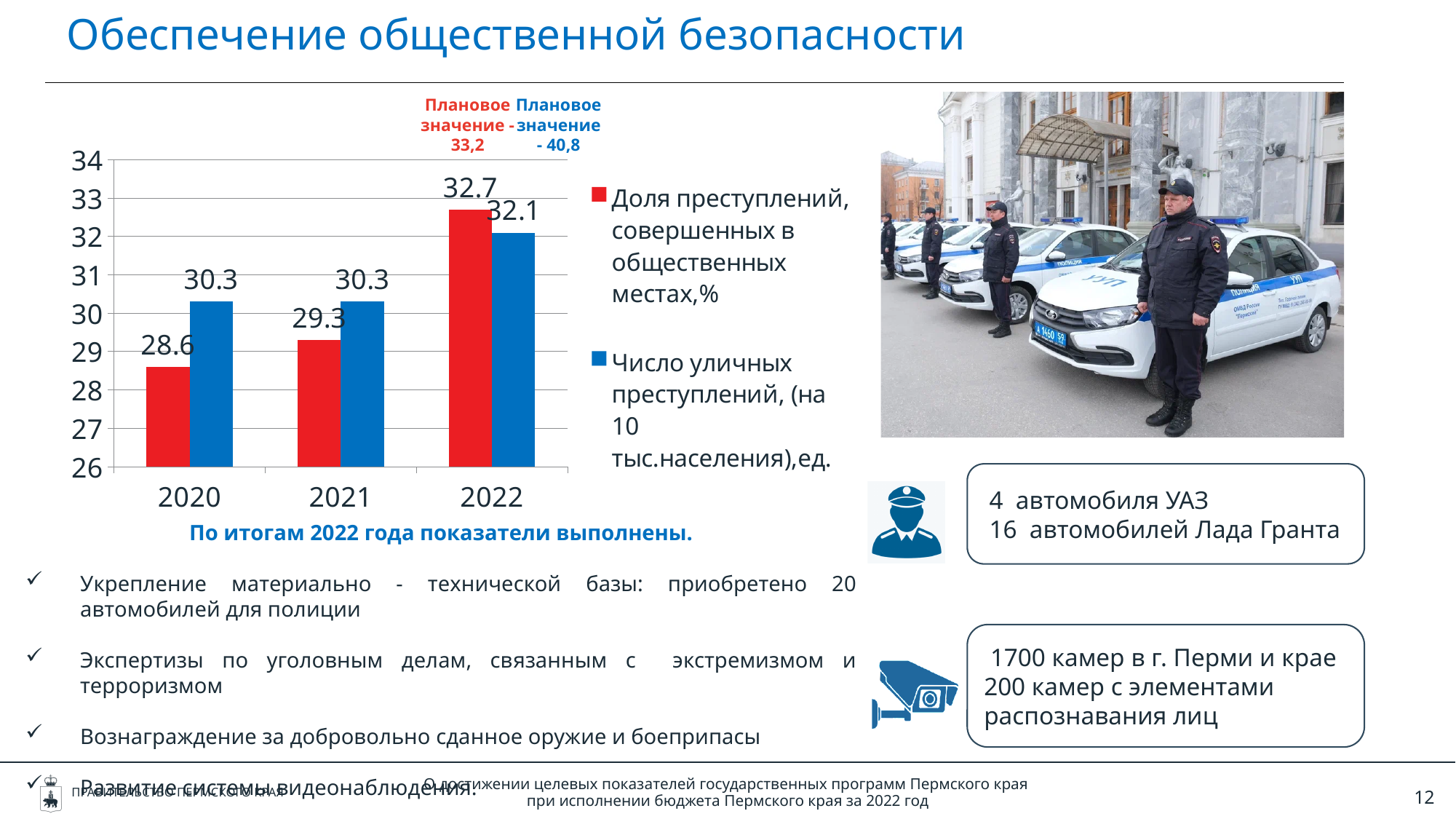
What type of chart is shown on the slide? bar chart In which year is 'Доля преступлений, совершенных в общественных местах,%' highest? 2022 How many years are shown on the x axis of the chart? 3 Which colour represents 'Число уличных преступлений, (на 10 тыс.населения),ед.' in the chart? blue What is the difference between the 2022 and 2020 values of 'Доля преступлений, совершенных в общественных местах,%'? 4.1 What is the value of 'Доля преступлений, совершенных в общественных местах,%' for 2020? 28.6 Does 'Доля преступлений, совершенных в общественных местах,%' rise or fall from 2020 to 2022? rise What is the value of 'Доля преступлений, совершенных в общественных местах,%' for 2021? 29.3 For 2021, which series has the larger value: 'Доля преступлений, совершенных в общественных местах,%' or 'Число уличных преступлений, (на 10 тыс.населения),ед.'? Число уличных преступлений, (на 10 тыс.населения),ед. How many series does the chart legend list? 2 What is the value of 'Число уличных преступлений, (на 10 тыс.населения),ед.' for 2022? 32.1 In which year is 'Доля преступлений, совершенных в общественных местах,%' lowest? 2020